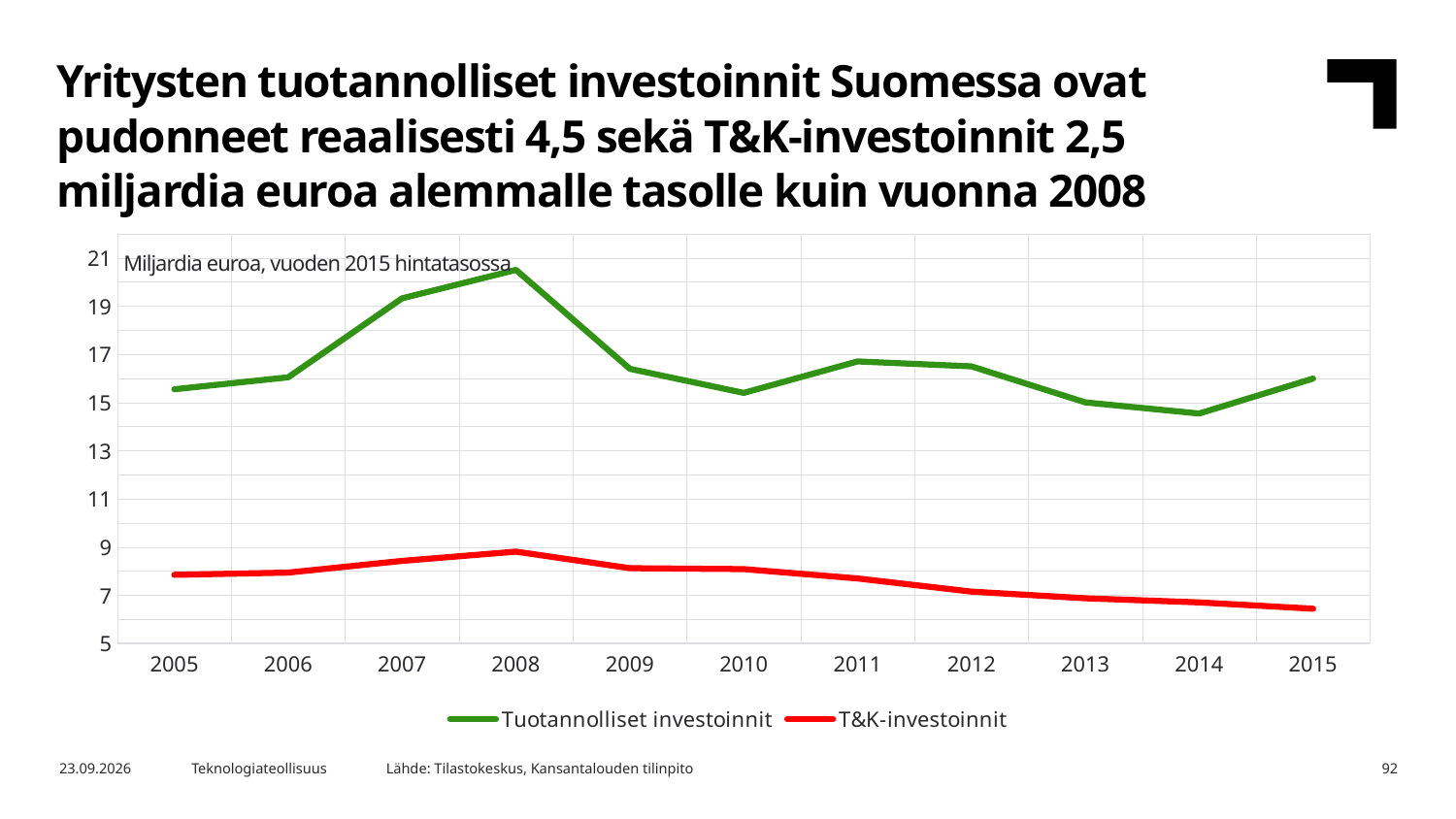
How many series does the legend list? 2 Which is larger: Tuotannolliset investoinnit in 2008 or in 2010? 2008 In which year is the value for Tuotannolliset investoinnit highest? 2008 Is the value for Tuotannolliset investoinnit in 2008 greater or less than 19? greater In which year is the value for Tuotannolliset investoinnit lowest? 2014 How many years are plotted along the x axis? 11 In which year is the value for T&K-investoinnit highest? 2008 What kind of chart is shown on the slide? Line chart Does the value for T&K-investoinnit rise or fall from 2008 to 2015? Fall Which colour is used for the T&K-investoinnit line? Red Is the value for T&K-investoinnit in 2015 greater or less than 7? less In which year is the value for T&K-investoinnit lowest? 2015